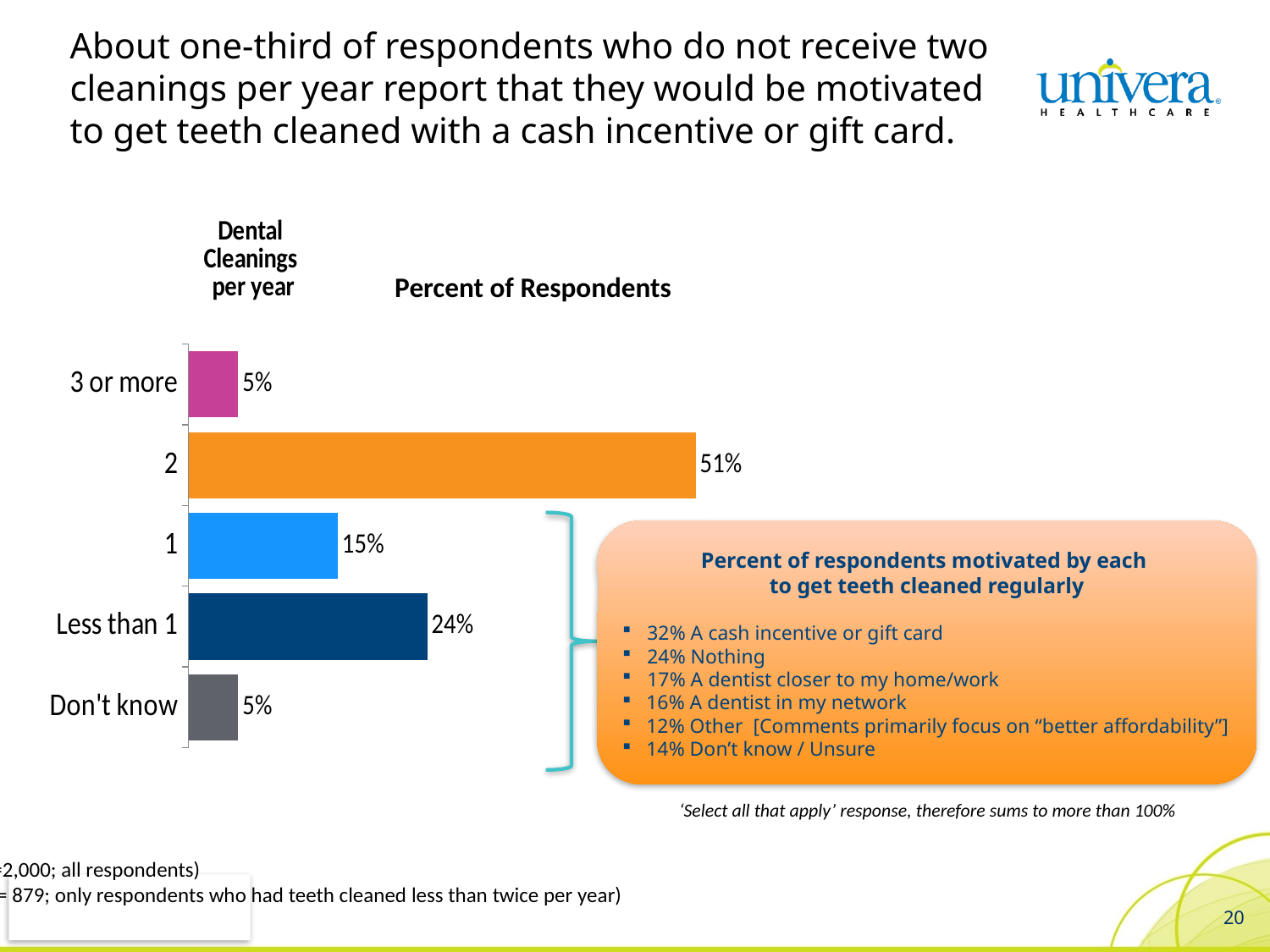
What is the difference in percent of respondents between '1' and '3 or more' cleanings per year? 10% What kind of chart is used to show the percent of respondents by dental cleanings per year? Bar chart What is the title of the value axis of the chart? Percent of Respondents Which dental cleanings per year category has the highest percent of respondents? 2 What percent of respondents answered 'Don't know' for dental cleanings per year? 5% What percent of respondents report less than 1 dental cleaning per year? 24% What percent of respondents report 1 dental cleaning per year? 15% Which has a larger percent of respondents: '1' or 'Less than 1' cleanings per year? Less than 1 What percent of respondents report 2 dental cleanings per year? 51% What is the difference in percent of respondents between the '2' and 'Less than 1' categories? 27% How many dental cleanings per year categories are shown in the chart? 5 What colour is the bar for the '2' dental cleanings per year category? Orange